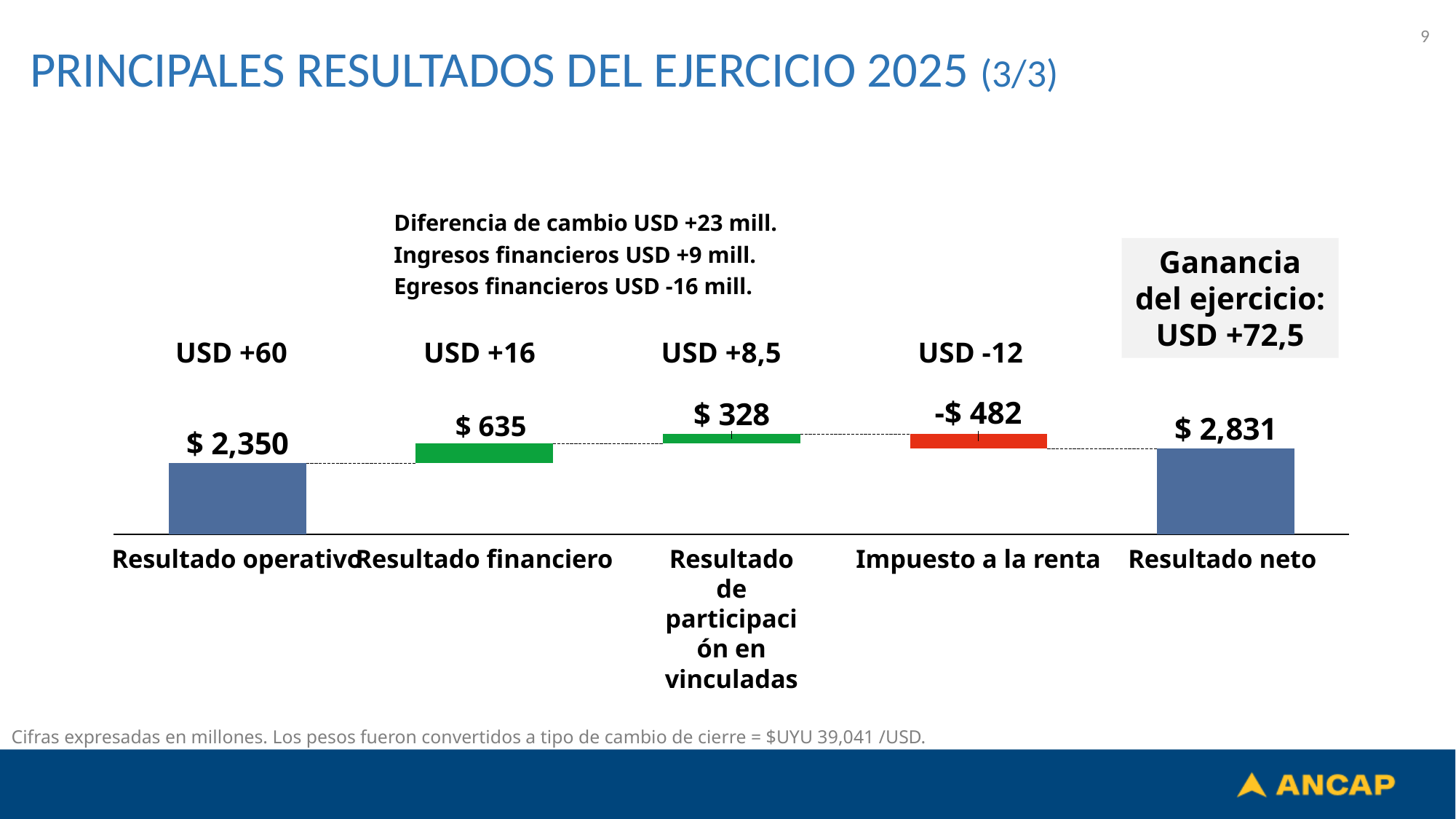
What USD amount is annotated above the Resultado de participación en vinculadas bar? USD +8,5 Which category has the lowest value in the chart? Impuesto a la renta What colour is the Impuesto a la renta bar? Red What is the value shown for Resultado financiero? $ 635 What is the value shown for Resultado neto? $ 2,831 How many categories are shown on the x axis of the chart? 5 Which category has the highest value in the chart? Resultado neto What is the value shown for Resultado operativo? $ 2,350 Which is larger, Resultado financiero or Resultado de participación en vinculadas? Resultado financiero What kind of chart is shown on the slide? Bar chart (waterfall) What is the value shown for Impuesto a la renta? -$ 482 What is the difference between Resultado neto and Resultado operativo? $ 481